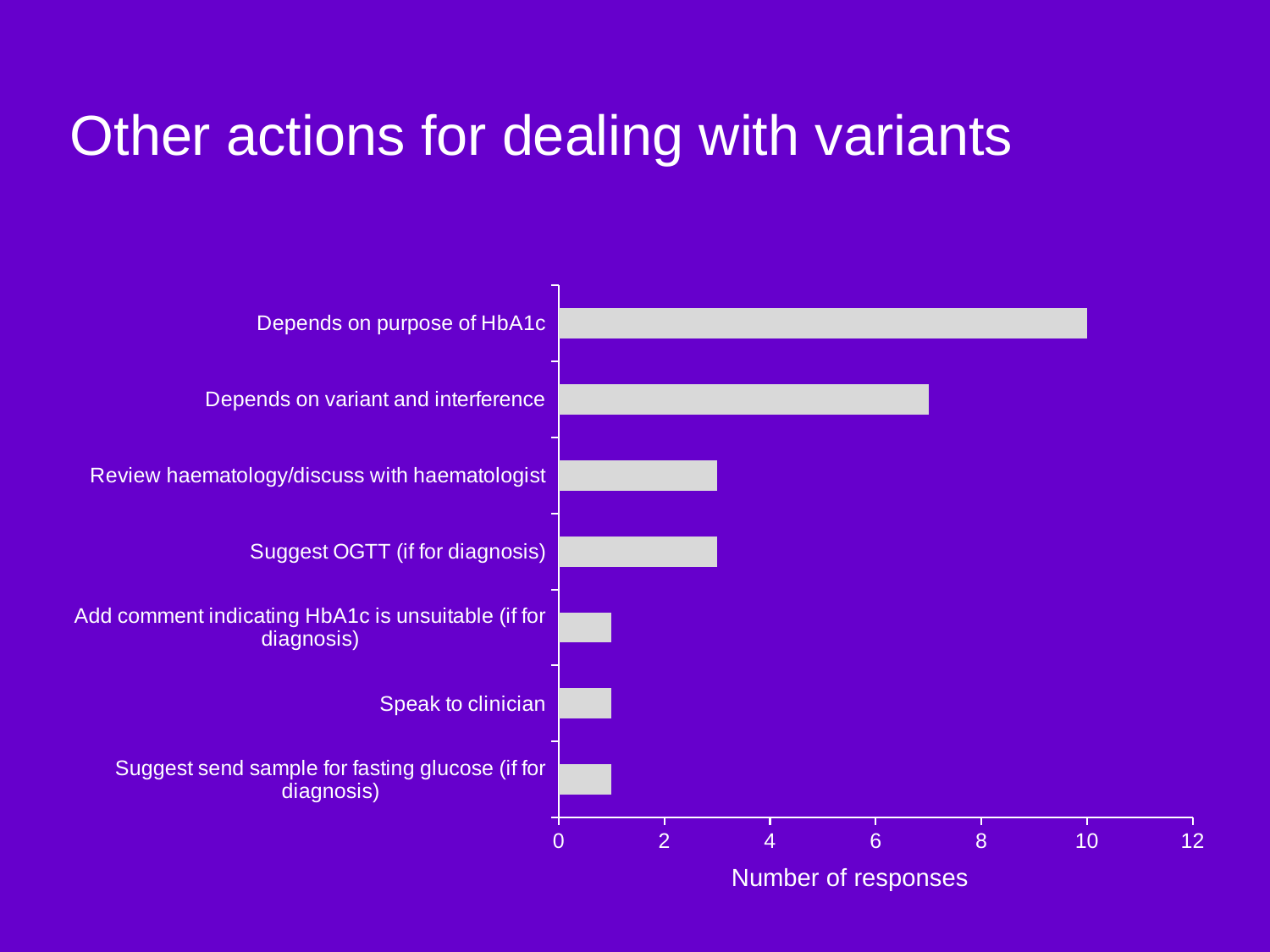
Is the number of responses for "Suggest OGTT (if for diagnosis)" greater or less than 2? greater Which has more responses: "Depends on variant and interference" or "Review haematology/discuss with haematologist"? Depends on variant and interference What type of chart is shown on the slide? bar chart Is the number of responses for "Depends on variant and interference" greater or less than 8? less Is the number of responses for "Depends on variant and interference" greater or less than 6? greater What is the label of the horizontal axis of the chart? Number of responses Which action received the highest number of responses? Depends on purpose of HbA1c How many categories (actions) are plotted in the chart? 7 What is the number of responses for "Depends on purpose of HbA1c"? 10 Which has more responses: "Suggest OGTT (if for diagnosis)" or "Speak to clinician"? Suggest OGTT (if for diagnosis)